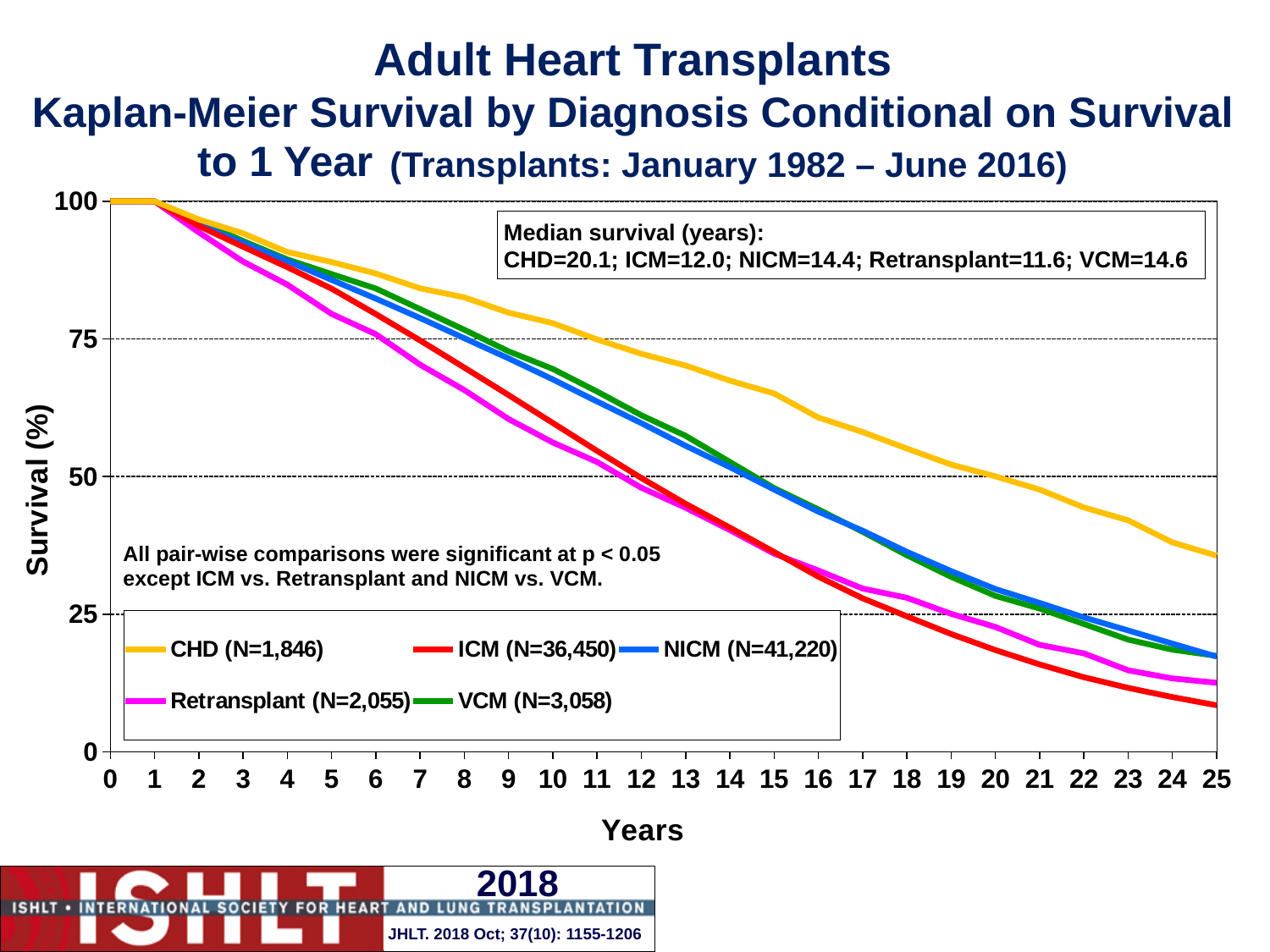
What is the N for the NICM group shown in the legend? 41,220 Do the survival curves rise or fall as years increase? Fall Which diagnosis group has the lowest median survival? Retransplant Which has the larger median survival, NICM or VCM? VCM What is the median survival in years for CHD? 20.1 Is the survival for ICM at 20 years greater or less than 25%? less Is the survival for CHD at 25 years greater or less than 25%? greater What is the median survival in years for Retransplant? 11.6 How many diagnosis groups does the legend list? 5 Which diagnosis group has the highest median survival? CHD What type of chart is shown on the slide? Line chart What is the difference in median survival (years) between CHD and ICM? 8.1